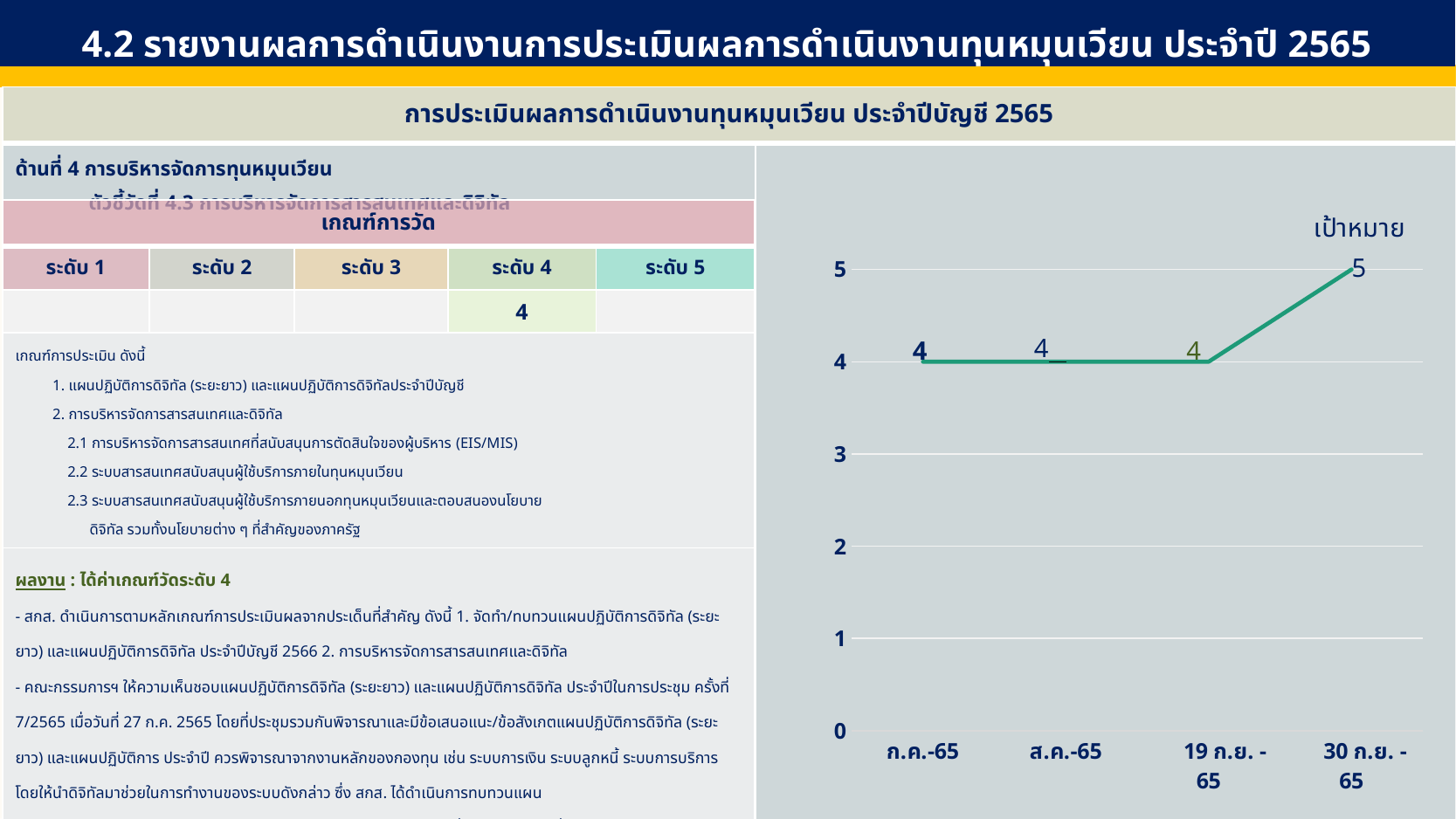
Which is larger, the value for 30 ก.ย. - 65 or the value for ส.ค.-65? 30 ก.ย. - 65 What is the value plotted for ส.ค.-65? 4 Is the value for 19 ก.ย. - 65 greater or less than 3? greater Do the values on the line chart rise, fall, or stay flat from ก.ค.-65 to 30 ก.ย. - 65? rise What is the value plotted for ก.ค.-65? 4 Which x-axis category has the highest value on the line chart? 30 ก.ย. - 65 How many data points are plotted on the line chart? 4 What is the value plotted for 19 ก.ย. - 65? 4 What kind of chart is shown on the right side of the slide? line chart What is the value plotted for 30 ก.ย. - 65? 5 What label appears above the last data point on the line chart? เป้าหมาย What is the difference between the value for 30 ก.ย. - 65 and the value for ก.ค.-65? 1